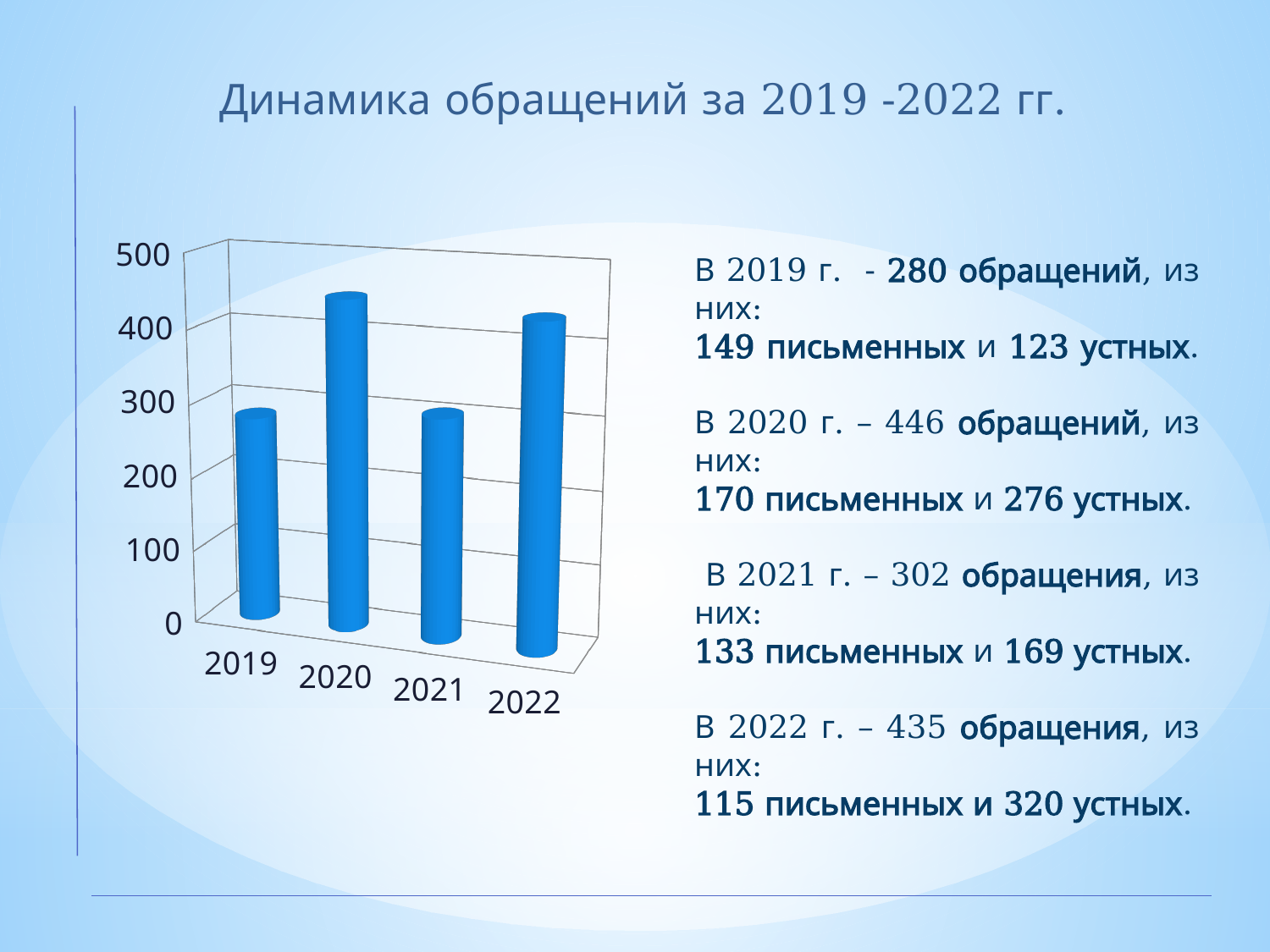
According to the slide, how many обращений were there in 2020? 446 According to the slide, how many обращения were there in 2022? 435 What kind of chart is shown on the slide? bar chart Which year has the highest bar on the chart? 2020 How many years (categories) are plotted on the chart? 4 According to the slide, how many обращений were there in 2019? 280 Is the value for 2020 greater or less than 400? greater Which year has the lowest bar on the chart? 2019 What is the title of the chart on the slide? Динамика обращений за 2019 -2022 гг. What is the difference between the number of обращений in 2020 and in 2019? 166 Is the value for 2019 greater or less than 300? less Which is larger, the value for 2019 or the value for 2020? 2020